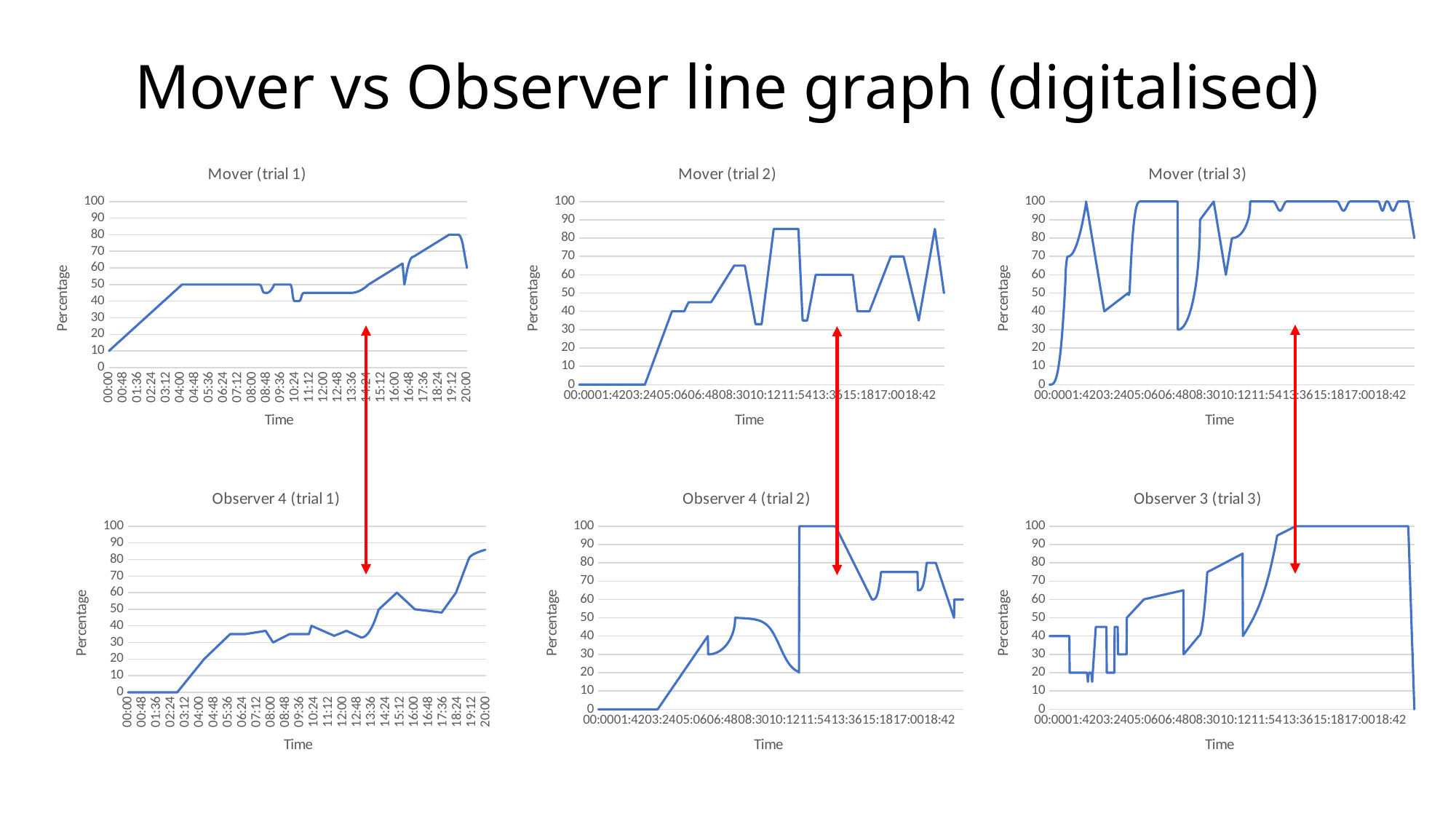
At 04:00, which chart shows the larger value: 'Mover (trial 1)' or 'Observer 4 (trial 1)'? Mover (trial 1) In the 'Mover (trial 2)' chart, is the value at 00:00 greater or less than 10? less What is the label on the horizontal axis of the 'Observer 3 (trial 3)' chart? Time How many charts are shown on the slide? 6 What is the label on the vertical axis of the 'Mover (trial 2)' chart? Percentage In the 'Observer 4 (trial 1)' chart, do the values generally rise or fall from 00:00 to 20:00? rise In the 'Observer 3 (trial 3)' chart, is the value at 00:00 greater or less than 20? greater In the 'Mover (trial 1)' chart, is the value at 00:00 greater or less than 50? less What kind of chart is 'Mover (trial 1)'? Line chart